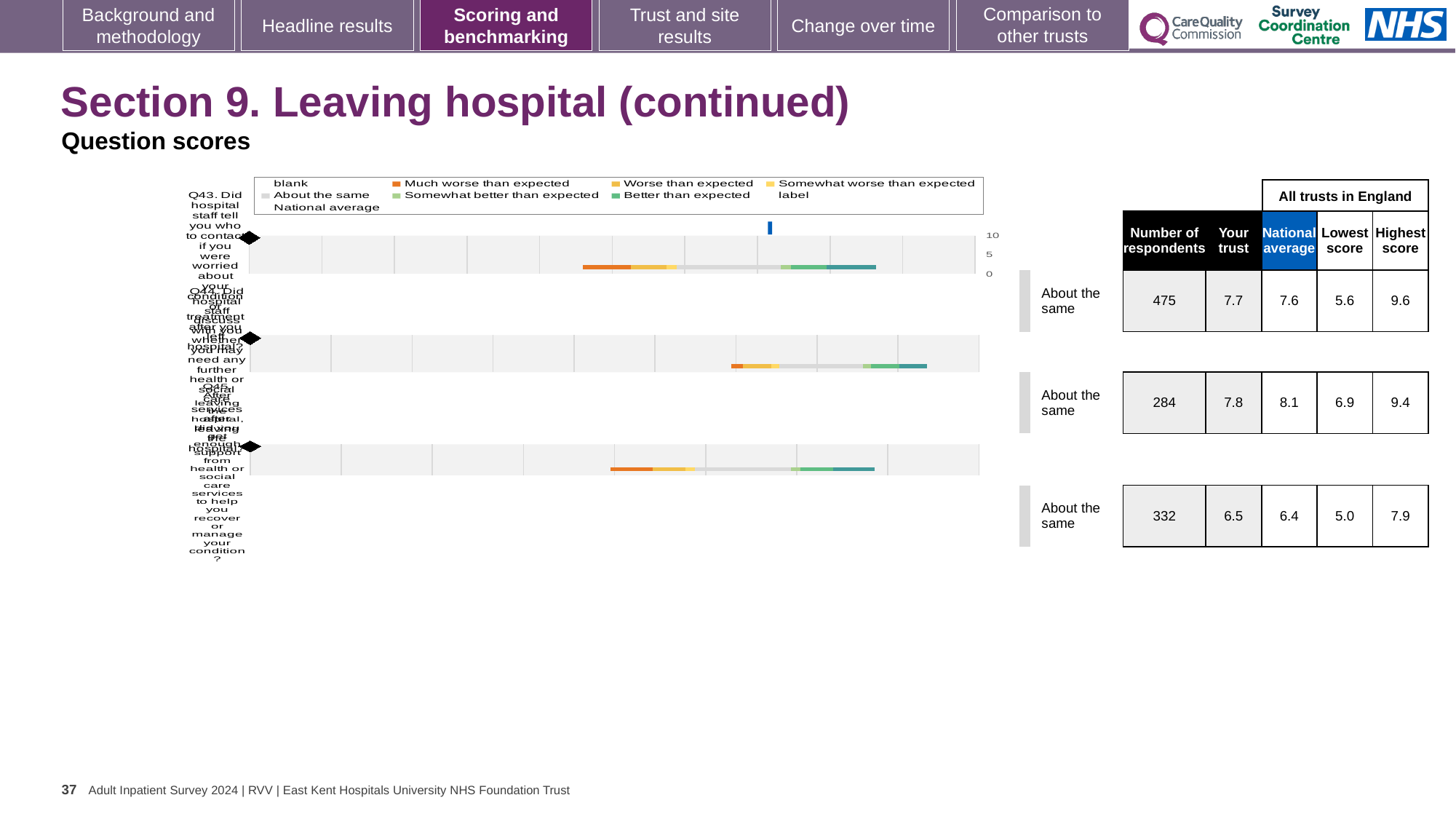
What benchmark category label is shown beside each of the three charts? About the same Which chart (top, middle or bottom) has the highest 'Your trust' score? middle For the middle chart, is the 'Your trust' score larger or smaller than the national average? smaller For the top chart, what is the 'Your trust' score shown in the table? 7.7 For the bottom chart, what is the highest score among all trusts in England? 7.9 For the middle chart, what is the lowest score among all trusts in England? 6.9 For the middle chart, how many respondents are shown in the table? 284 For the top chart, what is the national average score shown in the table? 7.6 For the top chart, what is the difference between the highest score and the lowest score? 4.0 In the legend, what does the orange colour represent? Much worse than expected What kind of chart is the top chart on the slide? bar chart How many benchmark charts are shown on the slide? 3